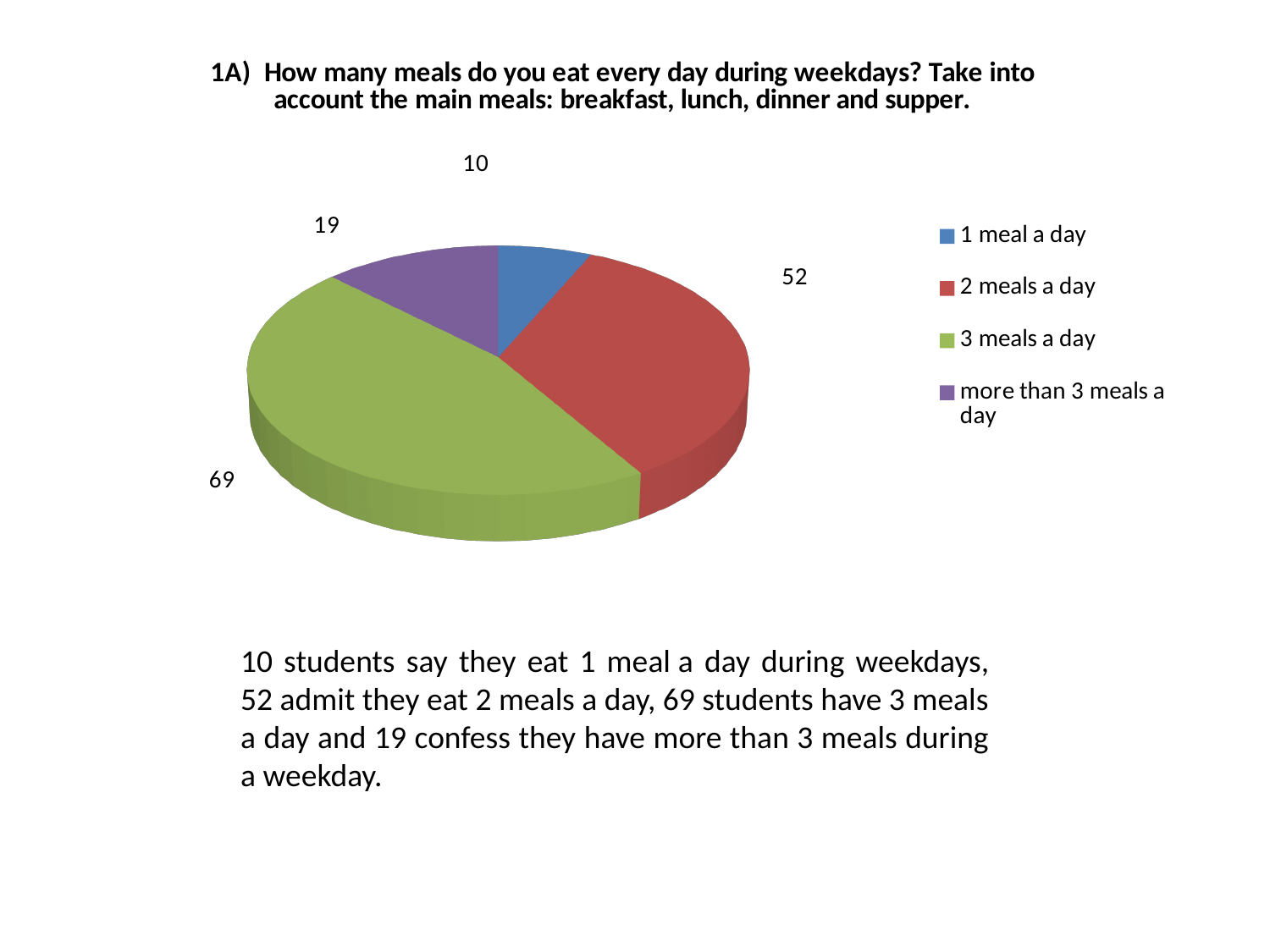
Which is larger: the value for '2 meals a day' or 'more than 3 meals a day'? 2 meals a day What is the difference between the values for '3 meals a day' and '2 meals a day'? 17 What is the total of all the slices in the pie chart? 150 What is the value for the 'more than 3 meals a day' slice? 19 What is the value for the '3 meals a day' slice? 69 How many categories does the pie chart have? 4 What share of the pie does the '3 meals a day' slice represent? 46% What type of chart is shown on the slide? Pie chart Which category has the largest slice of the pie? 3 meals a day What is the value for the '2 meals a day' slice? 52 How many students say they eat 1 meal a day? 10 Which category has the smallest slice of the pie? 1 meal a day